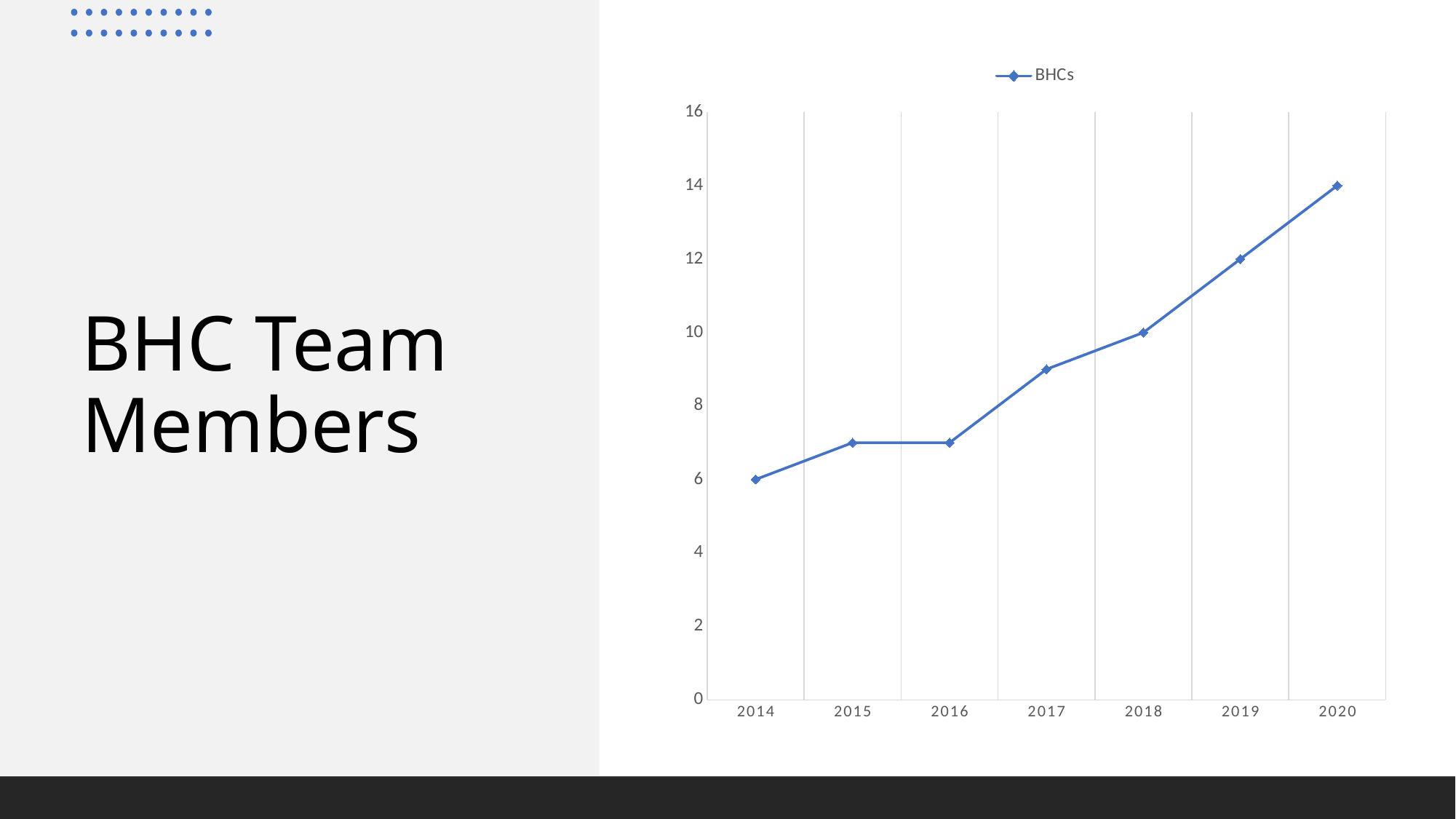
Is the value for BHCs in 2017 greater or less than 8? greater What is the name of the series shown in the legend? BHCs What is the difference between the BHCs value in 2020 and in 2014? 8 What is the value for BHCs in 2020? 14 Do the BHCs values generally rise or fall from 2014 to 2020? rise What is the value for BHCs in 2018? 10 How many years are plotted on the x axis? 7 Which year has the highest value for BHCs? 2020 How many series does the legend list? 1 What is the value for BHCs in 2014? 6 Which year has the lowest value for BHCs? 2014 What kind of chart is shown on the slide? line chart